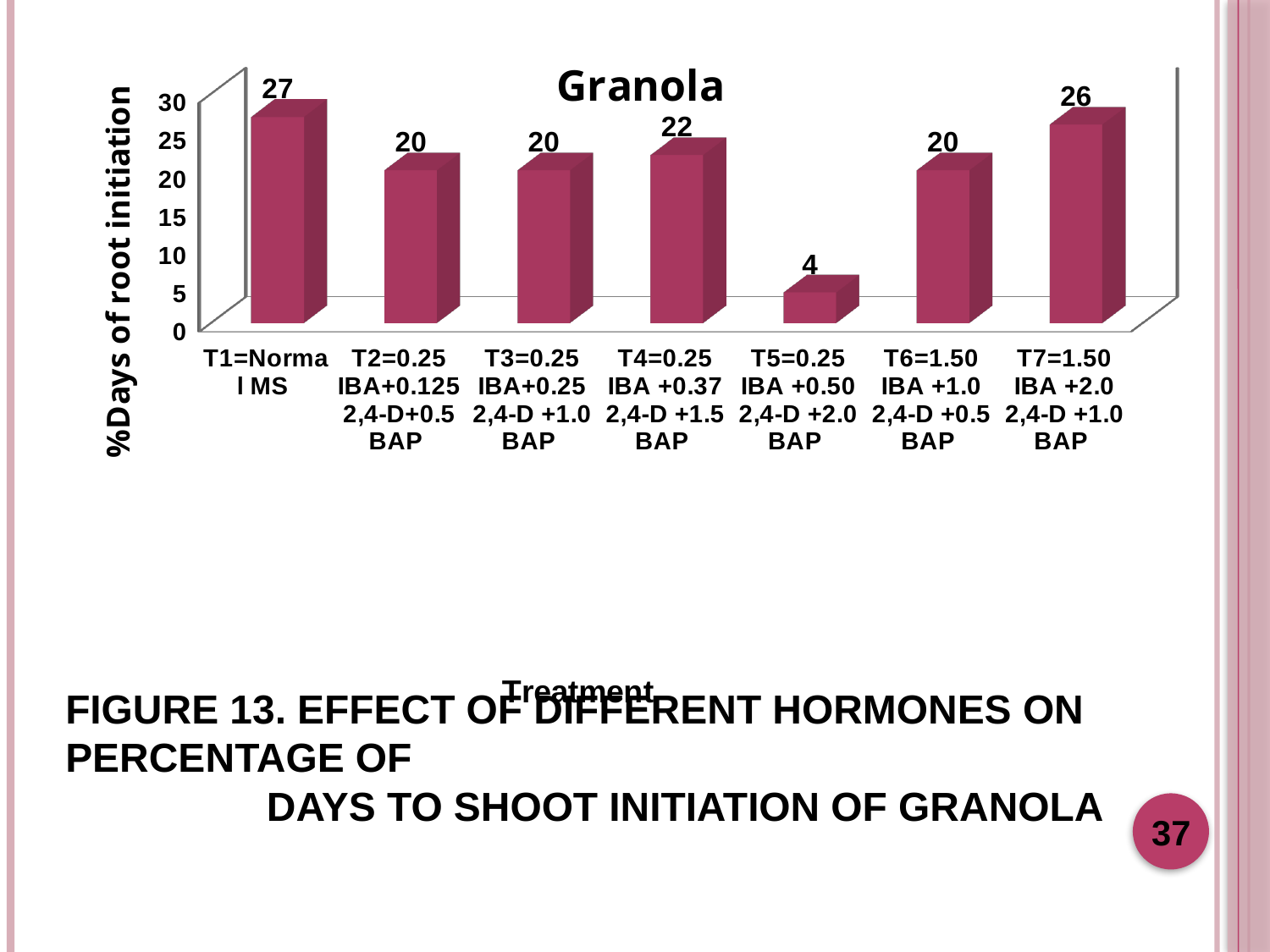
What kind of chart is this? Bar chart Which treatment has the highest value? T1=Normal MS How many treatments are shown on the x axis? 7 What is the difference between the values for T4 and T5? 18 What is the title of the chart? Granola Which treatment has the lowest value? T5=0.25 IBA +0.50 2,4-D +2.0 BAP What is the value for T5=0.25 IBA +0.50 2,4-D +2.0 BAP? 4 What is the value for T4=0.25 IBA +0.37 2,4-D +1.5 BAP? 22 What is the value for T1=Normal MS? 27 Which is larger, the value for T4 or the value for T6? T4 What is the value for T7=1.50 IBA +2.0 2,4-D +1.0 BAP? 26 What is the difference between the values for T1 and T7? 1